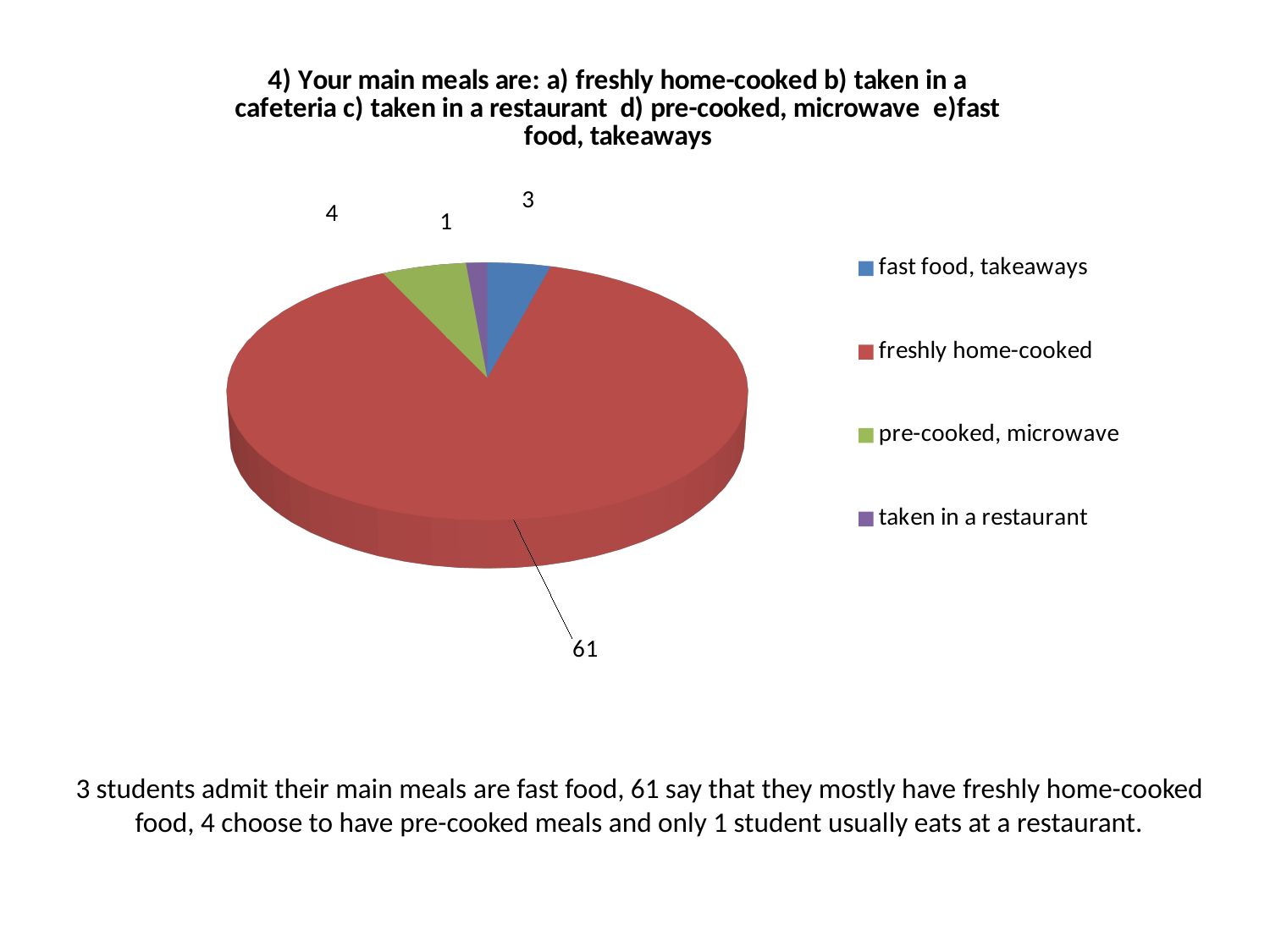
What is the value for the 'taken in a restaurant' slice? 1 What type of chart is shown on the slide? pie chart Which category has the smallest slice of the pie? taken in a restaurant What is the value for the 'pre-cooked, microwave' slice? 4 What is the difference between the 'freshly home-cooked' value and the 'pre-cooked, microwave' value? 57 Which category has the largest slice of the pie? freshly home-cooked What colour is the 'freshly home-cooked' slice in the legend? red What is the value for the 'fast food, takeaways' slice? 3 How many students say their main meals are freshly home-cooked? 61 Which is larger, the 'pre-cooked, microwave' slice or the 'fast food, takeaways' slice? pre-cooked, microwave How many categories does the pie chart show? 4 What is the total of all the values shown on the pie chart? 69